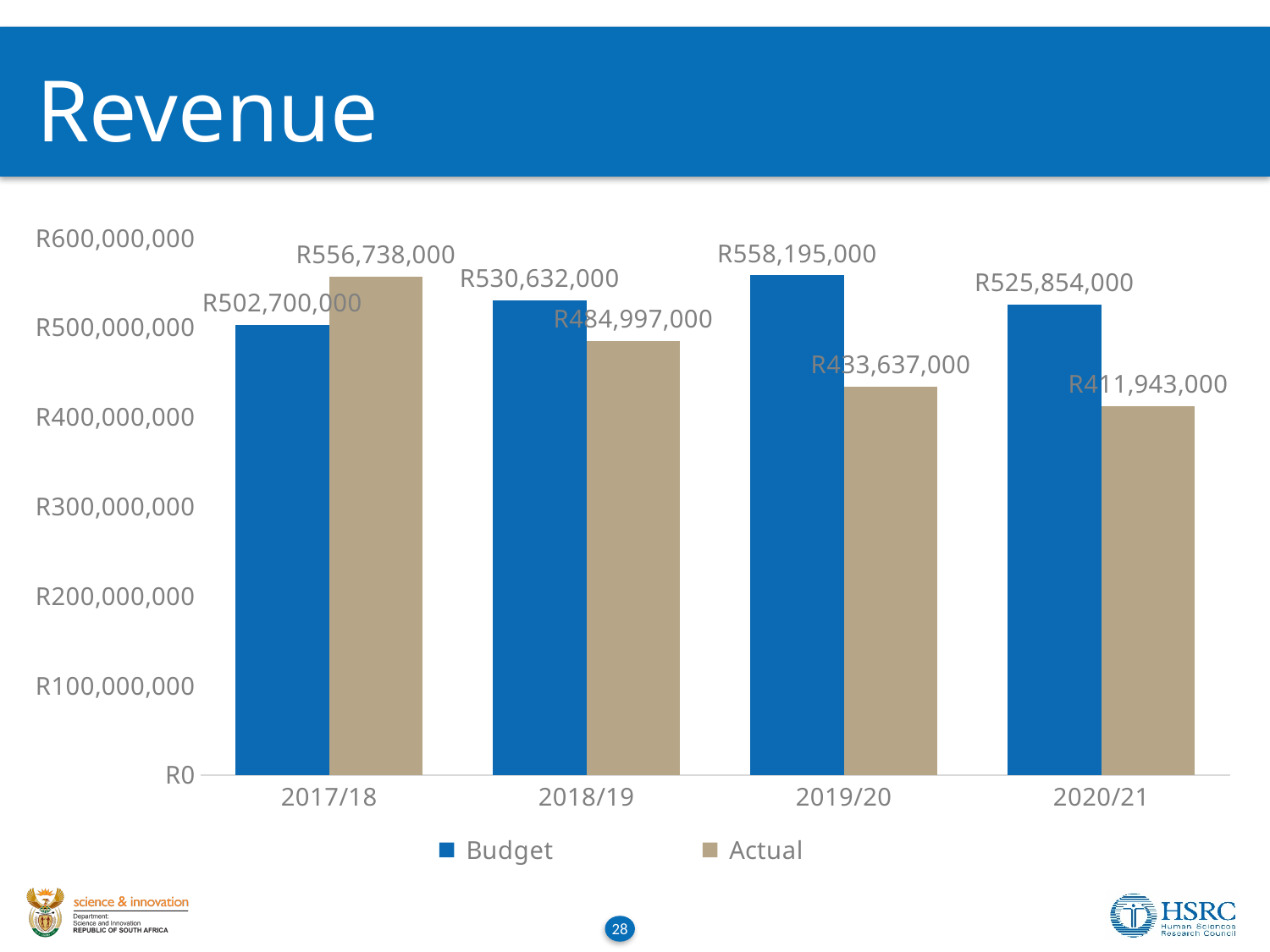
How many series does the legend list? 2 Which is larger in 2018/19, the Budget or the Actual value? Budget What is the Budget value for 2017/18? R502,700,000 How many years are shown on the x axis? 4 Do the Actual values rise or fall from 2017/18 to 2020/21? fall What is the Actual value for 2019/20? R433,637,000 What is the difference between the Budget and Actual values for 2019/20? R124,558,000 By how much does the Actual value exceed the Budget value in 2017/18? R54,038,000 Which year has the lowest Actual value? 2020/21 Which year has the highest Budget value? 2019/20 Is the Actual value for 2020/21 greater or less than R500,000,000? less What is the Actual value for 2020/21? R411,943,000